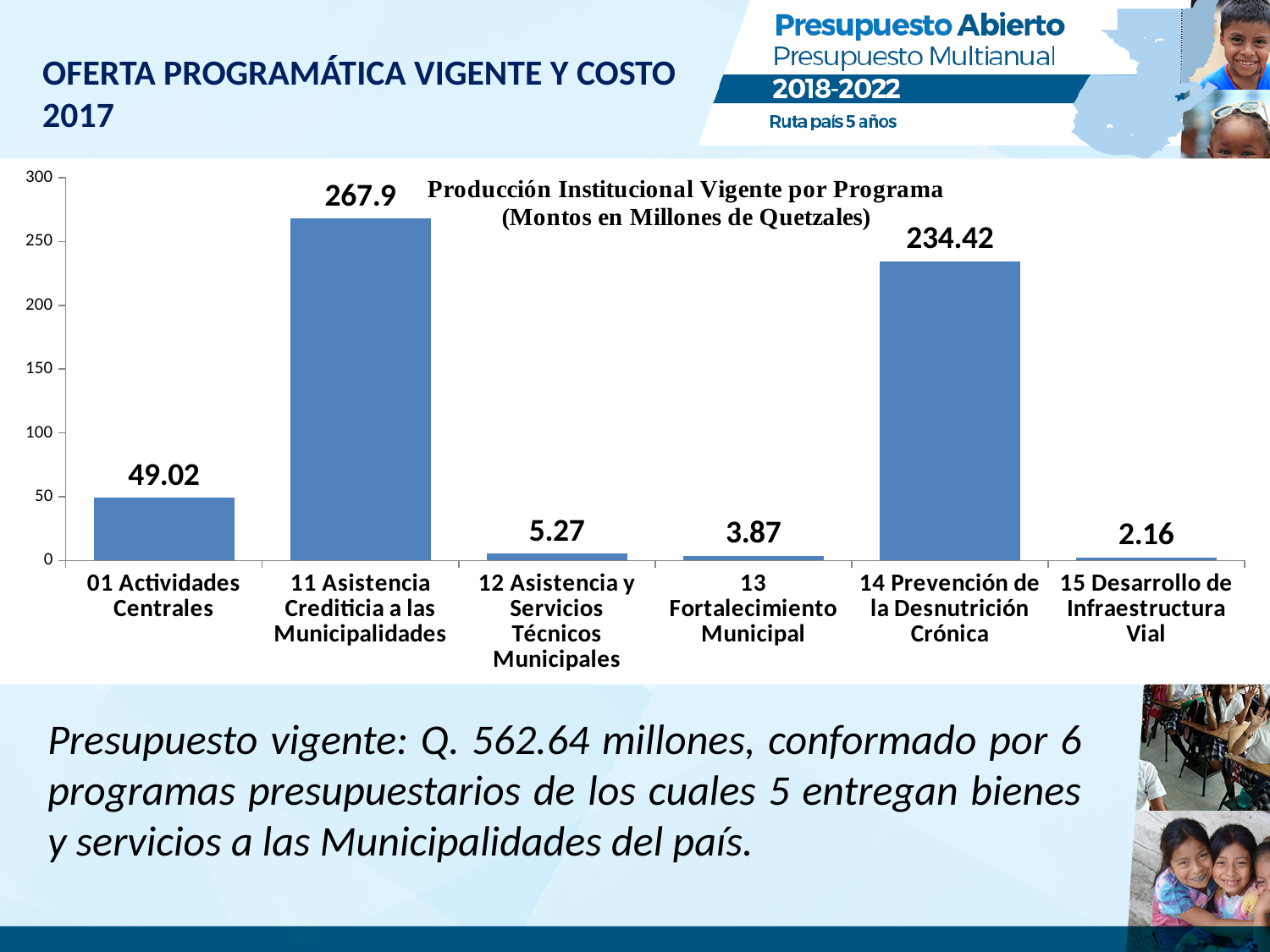
What is the difference between the values for 11 Asistencia Crediticia a las Municipalidades and 14 Prevención de la Desnutrición Crónica? 33.48 What type of chart is shown on the slide? Bar chart How many programs are shown in the chart? 6 Is the value for 14 Prevención de la Desnutrición Crónica greater or less than 200? greater Which program has the highest value? 11 Asistencia Crediticia a las Municipalidades What is the value for 14 Prevención de la Desnutrición Crónica? 234.42 What is the difference between the values for 01 Actividades Centrales and 12 Asistencia y Servicios Técnicos Municipales? 43.75 What is the value for 11 Asistencia Crediticia a las Municipalidades? 267.9 Which is larger, the value for 13 Fortalecimiento Municipal or the value for 12 Asistencia y Servicios Técnicos Municipales? 12 Asistencia y Servicios Técnicos Municipales Which program has the lowest value? 15 Desarrollo de Infraestructura Vial What is the value for 15 Desarrollo de Infraestructura Vial? 2.16 What is the value for 01 Actividades Centrales? 49.02